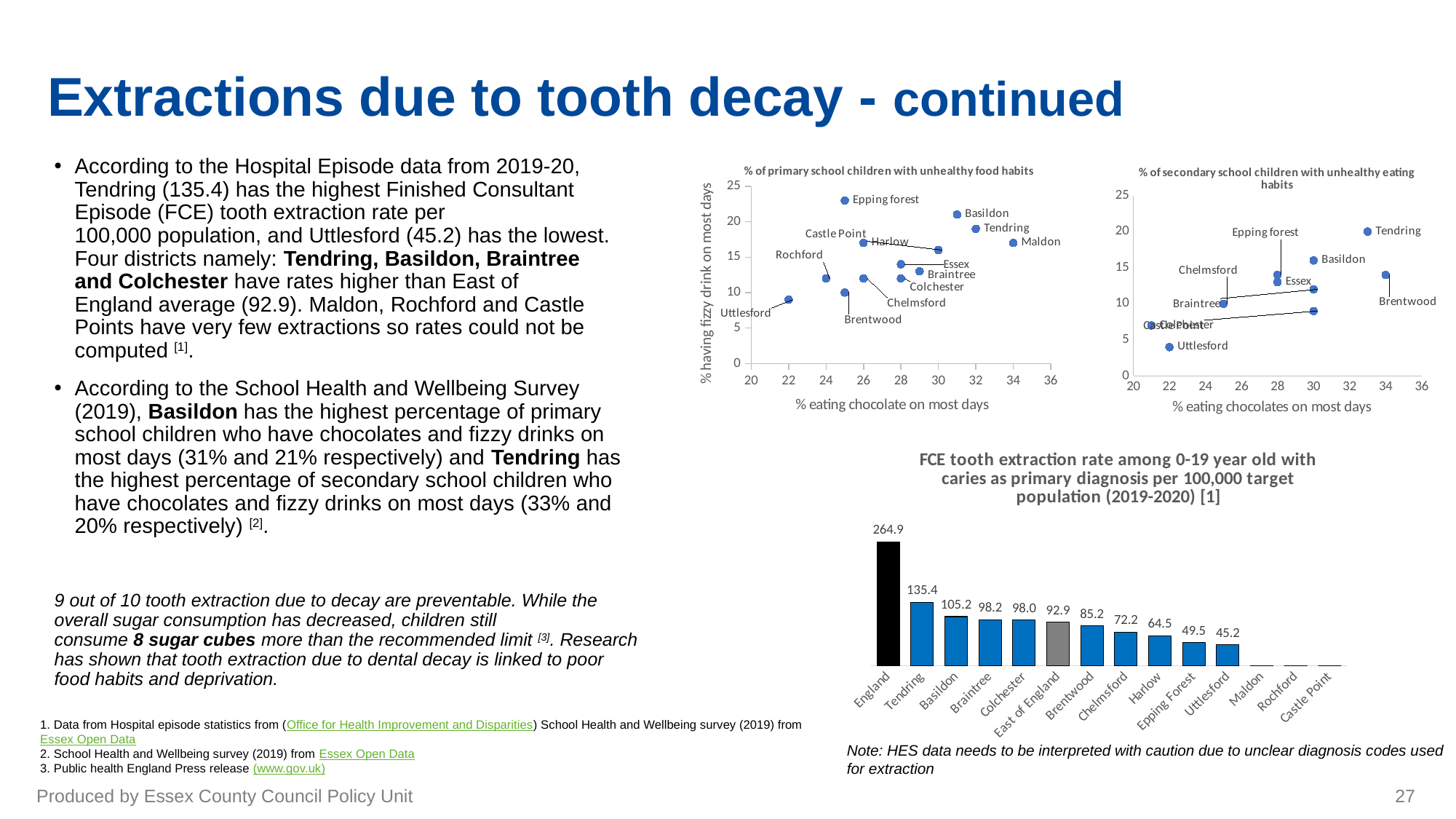
In the scatter chart titled '% of secondary school children with unhealthy eating habits', is the value on the vertical axis for Uttlesford greater or less than 5? less In the bar chart titled 'FCE tooth extraction rate among 0-19 year old', which is larger, the value for Brentwood or the value for Chelmsford? Brentwood In the bar chart titled 'FCE tooth extraction rate among 0-19 year old', what is the value for East of England? 92.9 In the bar chart titled 'FCE tooth extraction rate among 0-19 year old', which Essex district has the highest extraction rate? Tendring In the scatter chart titled '% of primary school children with unhealthy food habits', is the value on the vertical axis for Epping forest greater or less than 20? greater What kind of chart is the chart titled 'FCE tooth extraction rate among 0-19 year old'? bar chart In the bar chart titled 'FCE tooth extraction rate among 0-19 year old', what is the value for Tendring? 135.4 In the bar chart titled 'FCE tooth extraction rate among 0-19 year old', what is the difference between the values for Tendring and Basildon? 30.2 In the bar chart titled 'FCE tooth extraction rate among 0-19 year old', what is the value for Uttlesford? 45.2 What kind of chart is the chart titled '% of secondary school children with unhealthy eating habits'? scatter chart In the bar chart titled 'FCE tooth extraction rate among 0-19 year old', which category has the highest value? England In the bar chart titled 'FCE tooth extraction rate among 0-19 year old', how many categories are shown on the x axis? 14